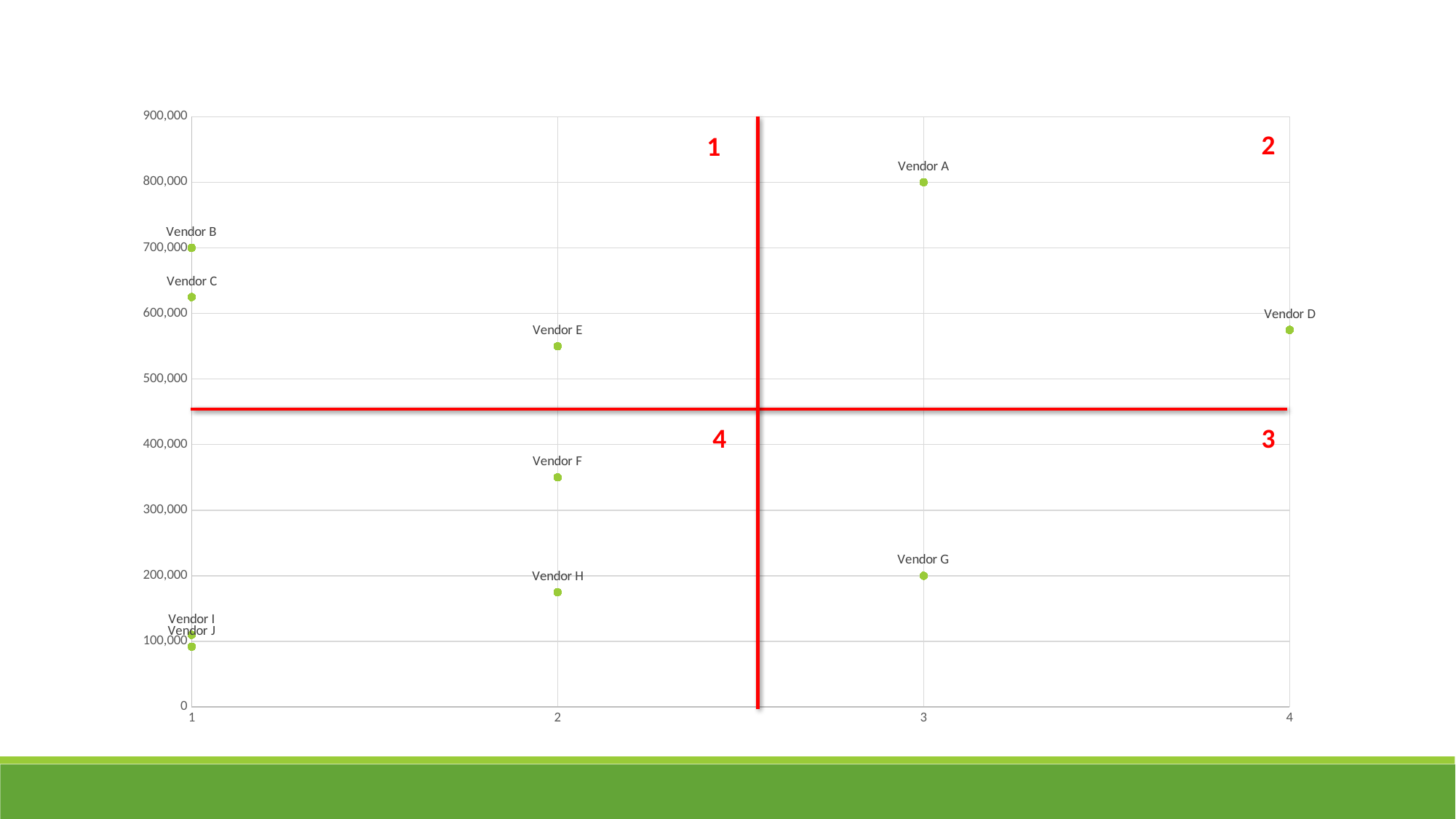
Is the vertical-axis value for Vendor D greater or less than 500,000? greater Which vendor has the highest value on the vertical axis? Vendor A Is the vertical-axis value for Vendor F greater or less than 400,000? less Which has the higher vertical-axis value, Vendor E or Vendor F? Vendor E What is the vertical-axis value for Vendor A? 800,000 Which red-numbered quadrant contains Vendor A? 2 What is the horizontal-axis value for Vendor G? 3 What kind of chart is shown on the slide? scatter chart What is the difference between the vertical-axis values of Vendor A and Vendor G? 600,000 How many vendor points are plotted on the chart? 10 What is the horizontal-axis value for Vendor D? 4 What is the vertical-axis value for Vendor B? 700,000